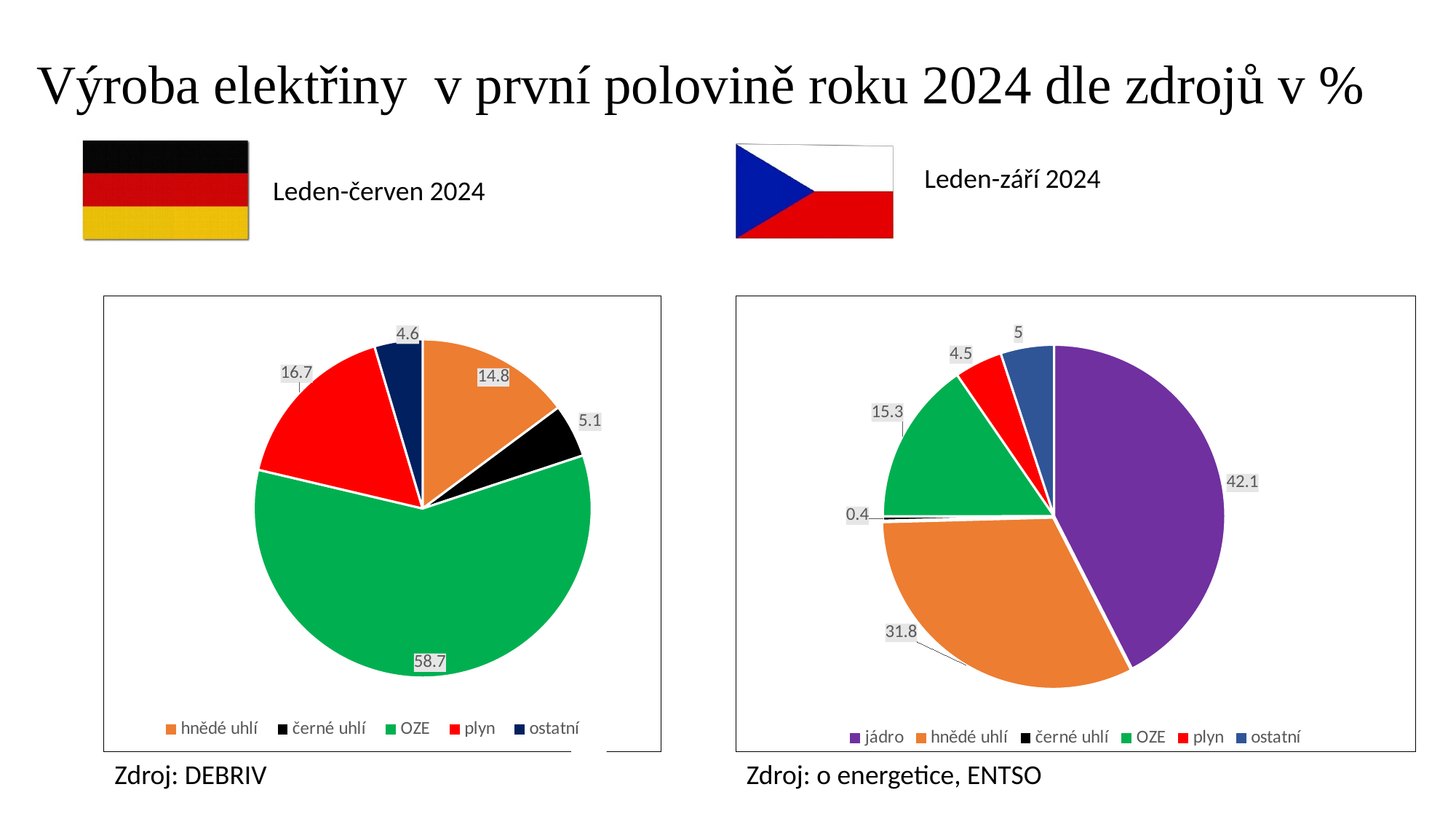
In the right pie chart (Czech Republic), what is the value for jádro? 42.1 In the left pie chart (Germany), what is the value for OZE? 58.7 In the right pie chart, which colour represents jádro? purple What type of chart is shown on the left side of the slide? pie chart In the right pie chart, what is the difference between jádro and hnědé uhlí? 10.3 In the left pie chart, which is larger, hnědé uhlí or plyn? plyn How many entries does the legend of the left chart list? 5 In the left pie chart, what is the value for plyn? 16.7 In the right pie chart, which category has the smallest slice? černé uhlí How many slices does the right pie chart have? 6 In the left pie chart, which category has the largest slice? OZE In the right pie chart, what is the value for černé uhlí? 0.4